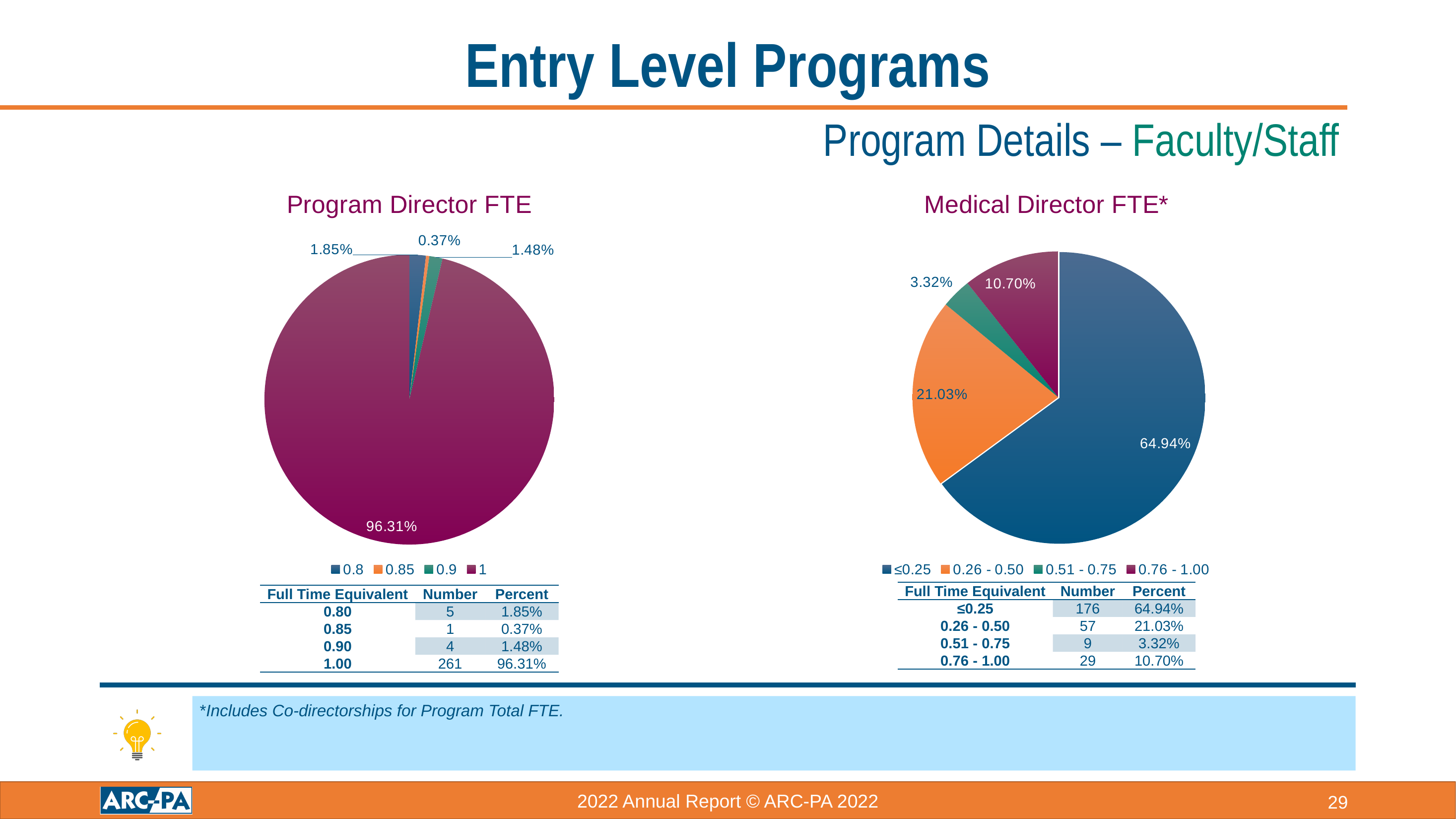
How many entries does the legend of the Medical Director FTE* chart list? 4 In the Medical Director FTE* chart, what share of the pie does the ≤0.25 slice represent? 64.94% In the Medical Director FTE* chart, which category has the smallest slice? 0.51 - 0.75 In the Program Director FTE chart, how many slices does the pie have? 4 In the Program Director FTE chart, which FTE category has the smallest slice? 0.85 What kind of chart is the Program Director FTE chart? Pie chart In the Program Director FTE chart, what is the difference in percent between the 0.8 slice and the 0.9 slice? 0.37% In the Program Director FTE chart, what share of the pie does the 1 slice represent? 96.31% In the Medical Director FTE* chart, what is the difference in percent between the ≤0.25 slice and the 0.26 - 0.50 slice? 43.91% In the Program Director FTE chart, what percentage is shown for the 0.85 slice? 0.37% In the Medical Director FTE* chart, what percentage is shown for the 0.26 - 0.50 slice? 21.03% In the Medical Director FTE* chart, which is larger, the 0.76 - 1.00 slice or the 0.51 - 0.75 slice? 0.76 - 1.00